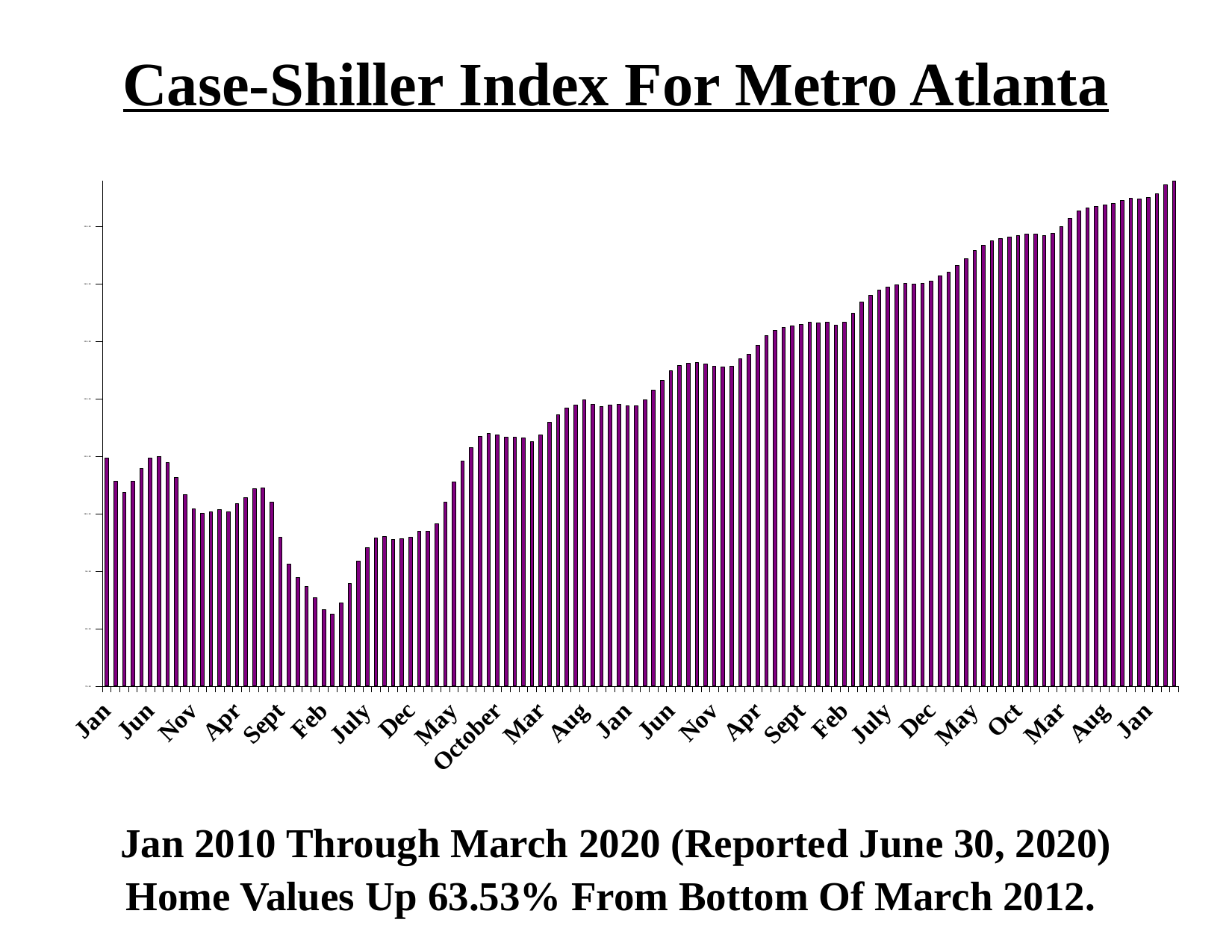
What kind of chart is shown on the slide? bar chart Between the first 'Jan' label and the 'Feb' label, do the values rise or fall? fall According to the slide, by what percentage are home values up from the bottom of March 2012? 63.53% Which is larger: the first bar (Jan) or the last bar on the right? the last bar What is the title of the chart? Case-Shiller Index For Metro Atlanta Overall, do the values rise or fall from the left end of the x axis to the right end? rise Is the highest bar at the left end or the right end of the chart? right end Which is larger: the bar at the first 'Jan' label or the bar at the 'Feb' label? Jan What colour are the bars in the chart? purple Which is larger: the bar at the first 'Nov' label or the bar at the first 'Dec' label? Nov